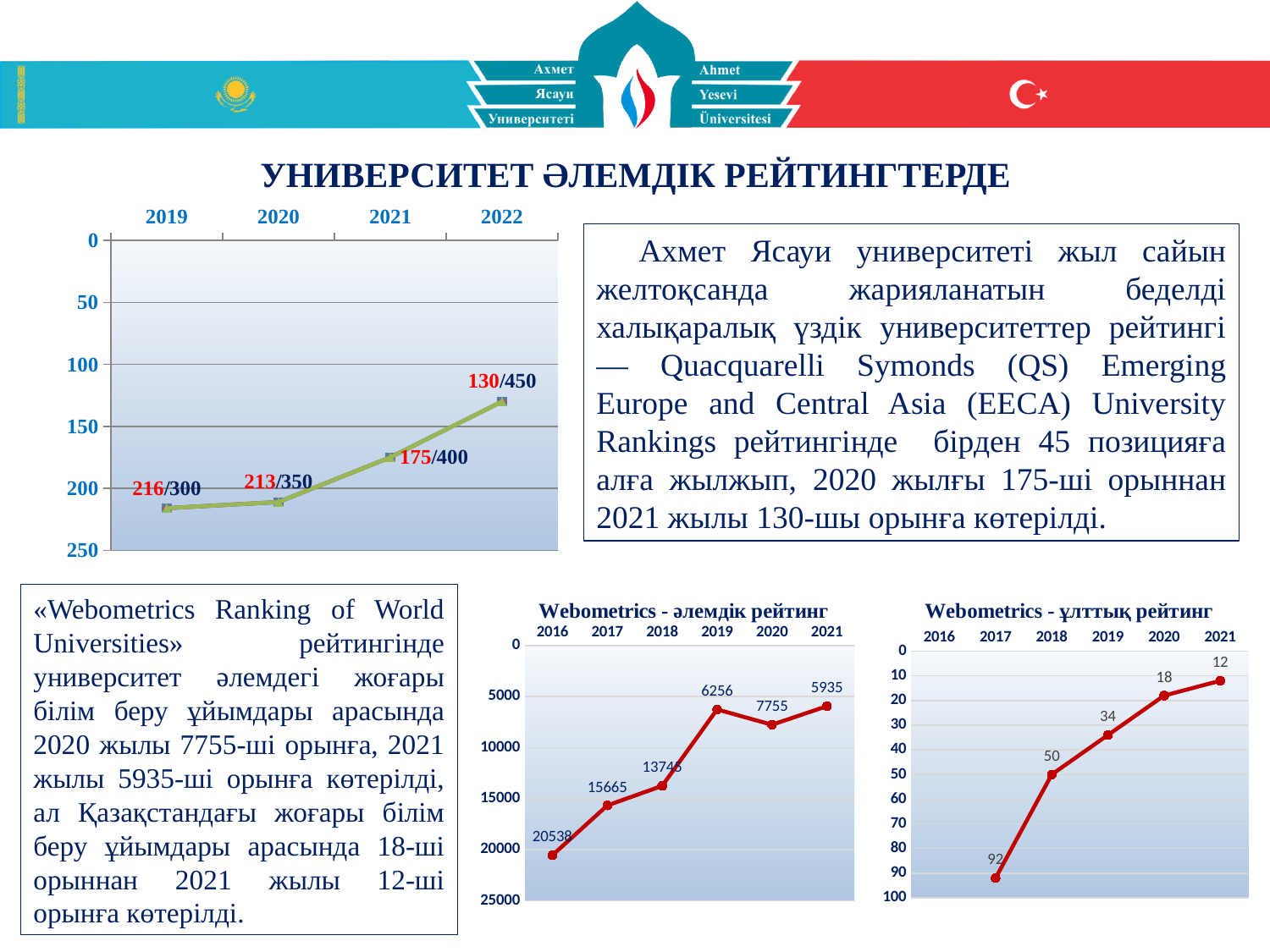
In the 'Webometrics - әлемдік рейтинг' chart, which is larger, the value for 2018 or the value for 2019? 2018 In the 'Webometrics - әлемдік рейтинг' chart, what is the difference between the 2020 value and the 2021 value? 1820 In the 'Webometrics - әлемдік рейтинг' chart, what is the value for 2016? 20538 In the 'Webometrics - ұлттық рейтинг' chart, do the values rise or fall from 2017 to 2021? fall In the 'Webometrics - әлемдік рейтинг' chart, what is the value for 2020? 7755 In the 'Webometrics - әлемдік рейтинг' chart, which year has the largest value? 2016 How many data points are plotted in the 'Webometrics - ұлттық рейтинг' chart? 5 In the 'Webometrics - ұлттық рейтинг' chart, what is the difference between the 2017 value and the 2021 value? 80 In the 'Webometrics - ұлттық рейтинг' chart, which year has the smallest value? 2021 What kind of chart is the 'Webometrics - әлемдік рейтинг' chart? line chart In the 'Webometrics - ұлттық рейтинг' chart, what is the value for 2019? 34 In the top-left chart, what is the data label on the rightmost point? 130/450